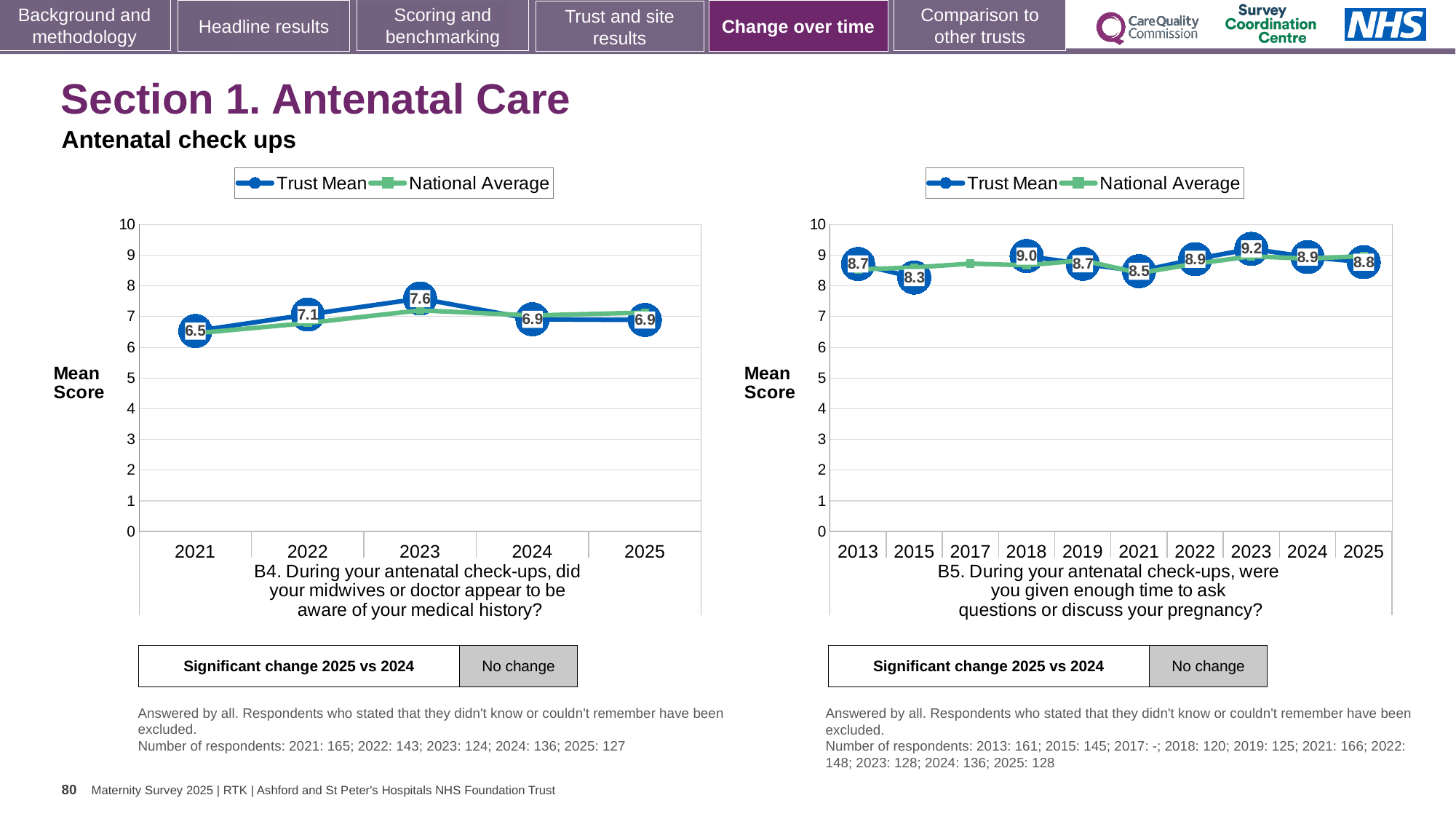
On the left chart (B4), what is the difference between the Trust Mean scores for 2023 and 2021? 1.1 On the right chart (B5), how many series does the legend list? 2 On the left chart (B4), which year has the lowest Trust Mean score? 2021 What type of chart is the left chart (B4)? Line chart On the right chart (B5), which year has the highest Trust Mean score? 2023 On the right chart (B5), what is the Trust Mean score for 2015? 8.3 On the left chart (B4), which year has the highest Trust Mean score? 2023 On the right chart (B5), what is the Trust Mean score for 2023? 9.2 On the left chart (B4), what is the Trust Mean score for 2021? 6.5 On the right chart (B5), is the Trust Mean score for 2018 or 2021 larger? 2018 On the left chart (B4), how many years are shown on the x axis? 5 On the left chart (B4), what is the Trust Mean score for 2023? 7.6